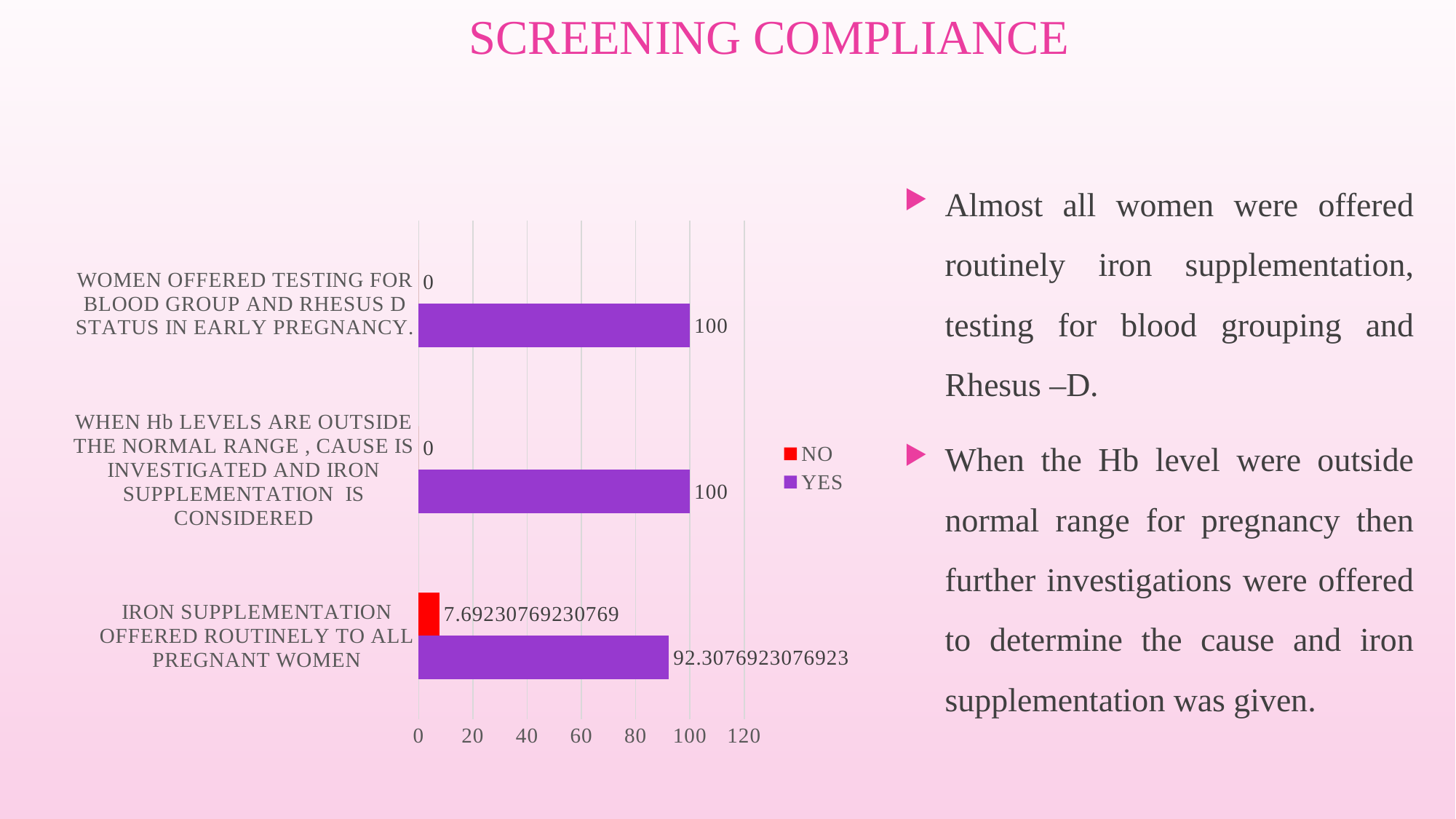
What is the NO value for 'Iron supplementation offered routinely to all pregnant women'? 7.69230769230769 How many series does the chart legend list? 2 Is the YES value for 'Iron supplementation offered routinely to all pregnant women' greater or less than 100? less What kind of chart is shown on the slide? bar chart What is the YES value for 'Iron supplementation offered routinely to all pregnant women'? 92.3076923076923 What is the YES value for 'Women offered testing for blood group and Rhesus D status in early pregnancy'? 100 What colour are the YES bars in the chart? purple Which category has the highest NO value? Iron supplementation offered routinely to all pregnant women What is the NO value for 'When Hb levels are outside the normal range, cause is investigated and iron supplementation is considered'? 0 Which is larger for 'Iron supplementation offered routinely to all pregnant women': the YES value or the NO value? YES Which category has the lowest YES value? Iron supplementation offered routinely to all pregnant women How many categories are shown on the chart? 3